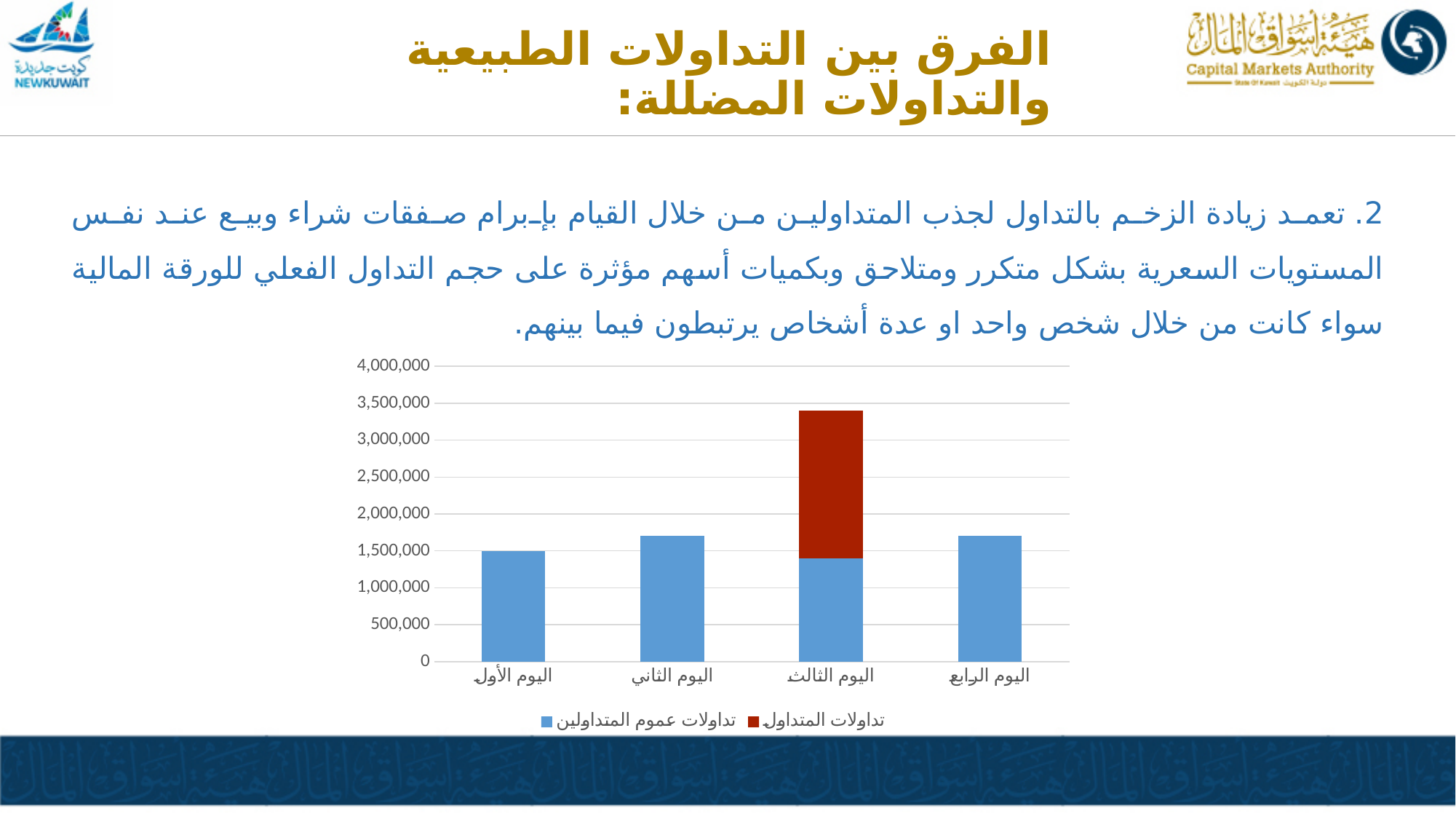
Which bar is taller, اليوم الثالث or اليوم الأول? اليوم الثالث How many categories (days) are shown on the x axis of the chart? 4 What colour represents the series تداولات عموم المتداولين in the chart? blue Which day has the shortest bar in the chart? اليوم الأول Is the value for اليوم الثاني greater or less than 1,500,000? greater Is the value for اليوم الرابع greater or less than 2,000,000? less What kind of chart is shown on the slide? bar chart How many series does the chart legend list? 2 Which day is the only one with a segment for the series تداولات المتداول? اليوم الثالث Which day has the tallest bar in the chart? اليوم الثالث Is the value for اليوم الأول greater or less than 2,000,000? less